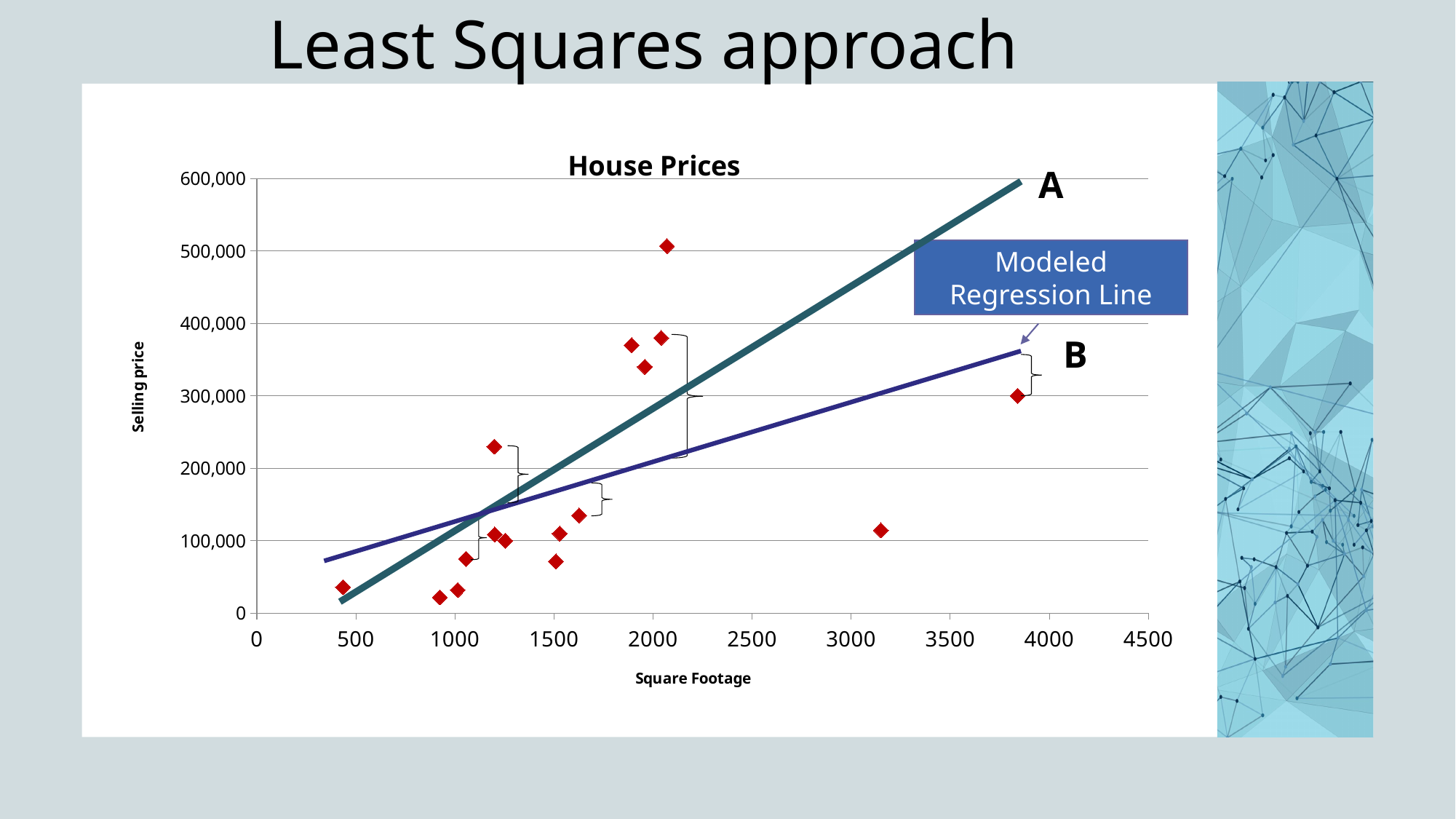
Is the selling price of the highest data point greater or less than 400,000? greater Is the selling price of the data point with the largest square footage greater or less than 200,000? greater Which line, A or B, is labeled as the Modeled Regression Line? B Is the selling price of the data point with the smallest square footage greater or less than 100,000? less Which of the two lines, A or B, is steeper? A Do selling prices generally rise or fall as square footage increases along the x axis? rise What kind of chart is shown on the slide? scatter chart What is the title of the chart? House Prices